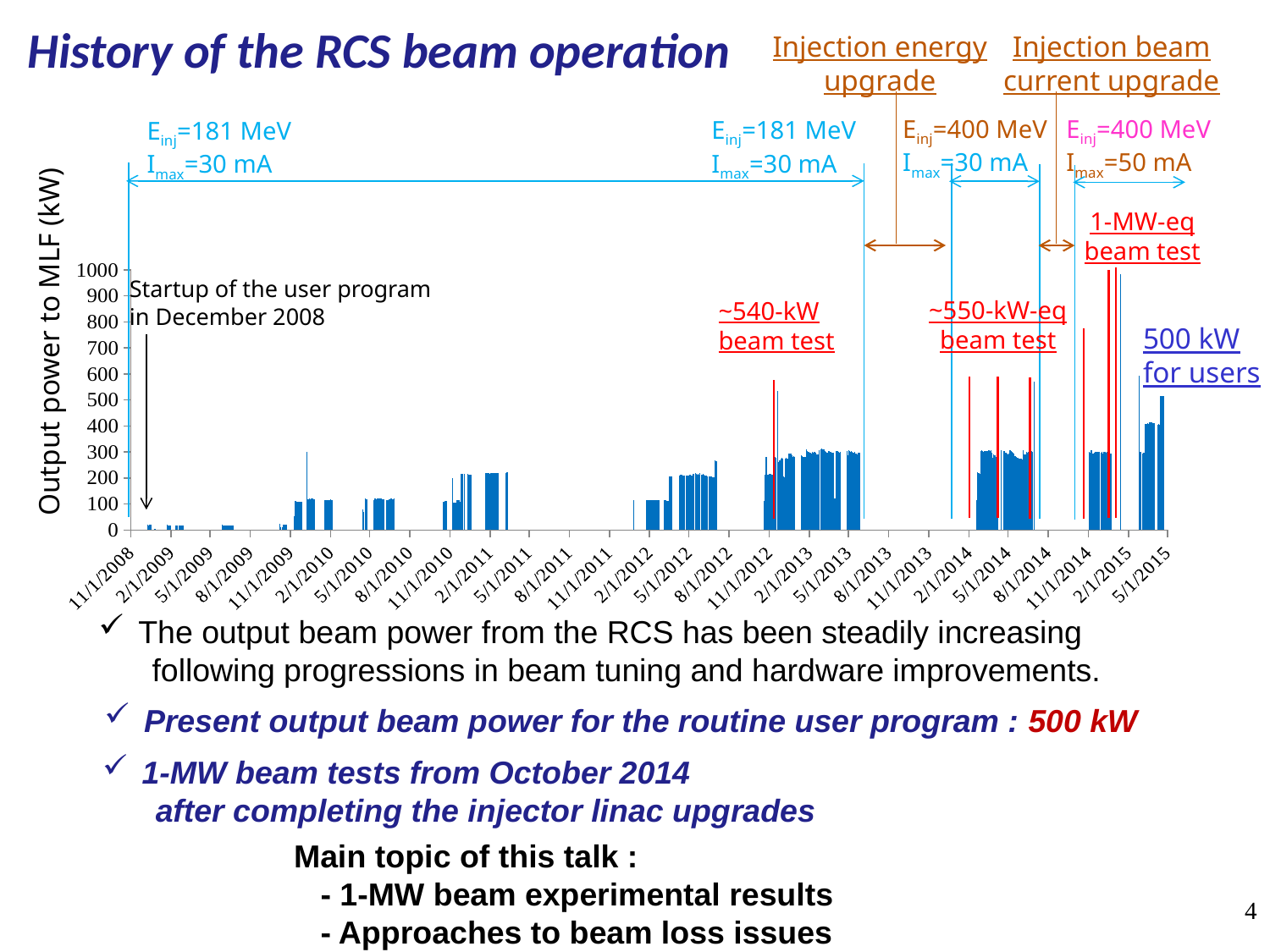
Is the output power for the bars around 2/1/2013 greater or less than 200? greater Which is larger: the output power of the bars around 5/1/2015 or the bars around 2/1/2010? around 5/1/2015 Is the output power for the bars around 2/1/2009 greater or less than 100? less Which is larger: the output power of the bars around 5/1/2014 or the bars around 11/1/2010? around 5/1/2014 What is the label of the vertical axis of the chart? Output power to MLF (kW) Is the output power for the bars around 5/1/2012 greater or less than 100? greater What kind of chart is shown on the slide? bar chart Overall, do the output power values rise or fall along the x axis from 11/1/2008 to 5/1/2015? rise What is the title of the slide's chart? History of the RCS beam operation